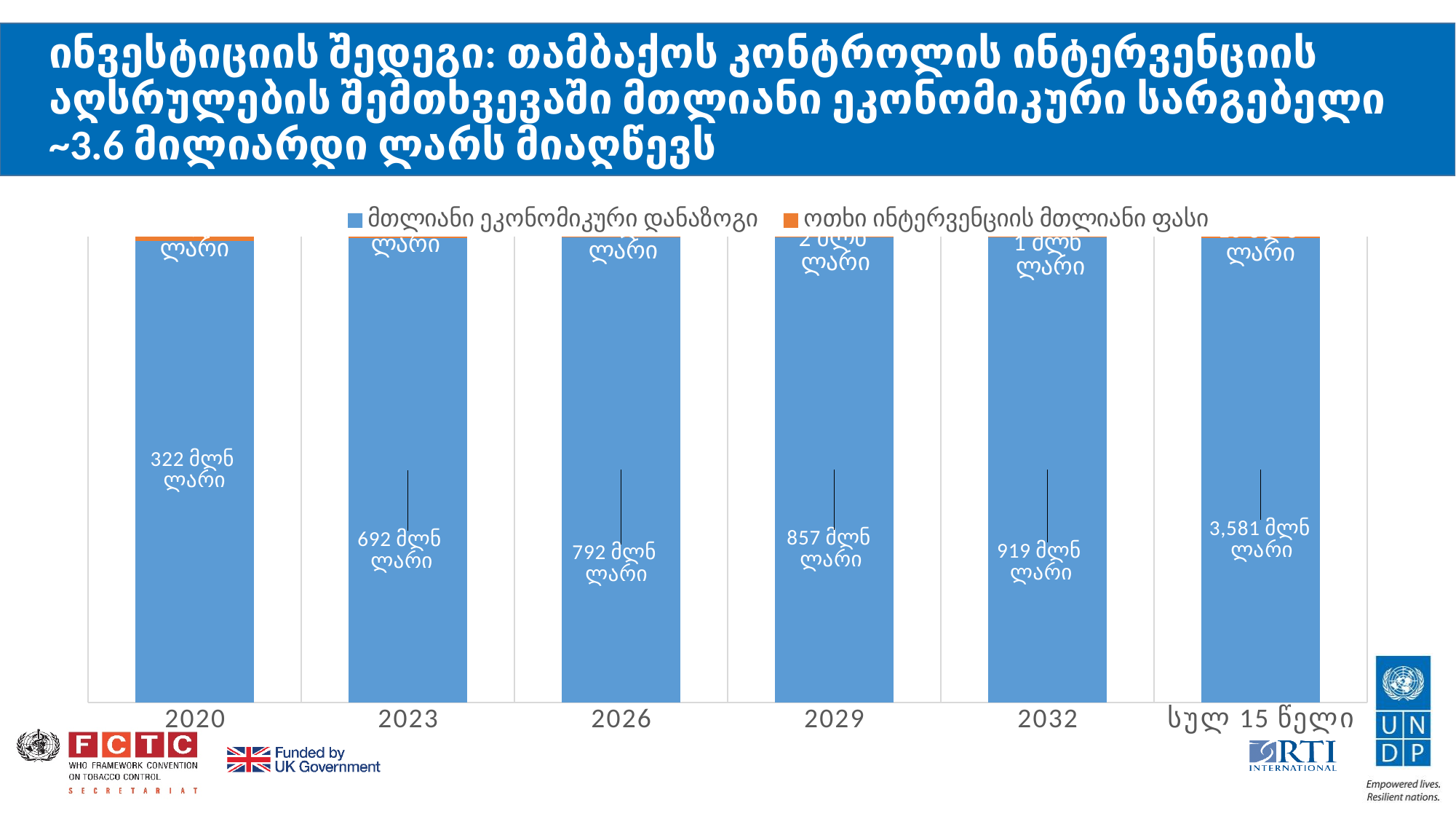
Which category has the highest value for the blue series (მთლიანი ეკონომიკური დანაზოგი)? სულ 15 წელი What is the value of the blue series (მთლიანი ეკონომიკური დანაზოგი) for 2023? 692 მლნ ლარი Which category has the lowest value for the blue series (მთლიანი ეკონომიკური დანაზოგი)? 2020 What is the value of the blue series (მთლიანი ეკონომიკური დანაზოგი) for 2029? 857 მლნ ლარი What is the value of the blue series (მთლიანი ეკონომიკური დანაზოგი) for 2032? 919 მლნ ლარი What is the difference between the blue series values for 2032 and 2020? 597 მლნ ლარი What is the value of the blue series (მთლიანი ეკონომიკური დანაზოგი) for სულ 15 წელი? 3,581 მლნ ლარი What is the value of the blue series (მთლიანი ეკონომიკური დანაზოგი) for 2020? 322 მლნ ლარი Which is larger for the blue series: the value for 2026 or the value for 2023? 2026 How many series does the legend list? 2 How many categories are shown on the x axis? 6 What is the value of the blue series (მთლიანი ეკონომიკური დანაზოგი) for 2026? 792 მლნ ლარი